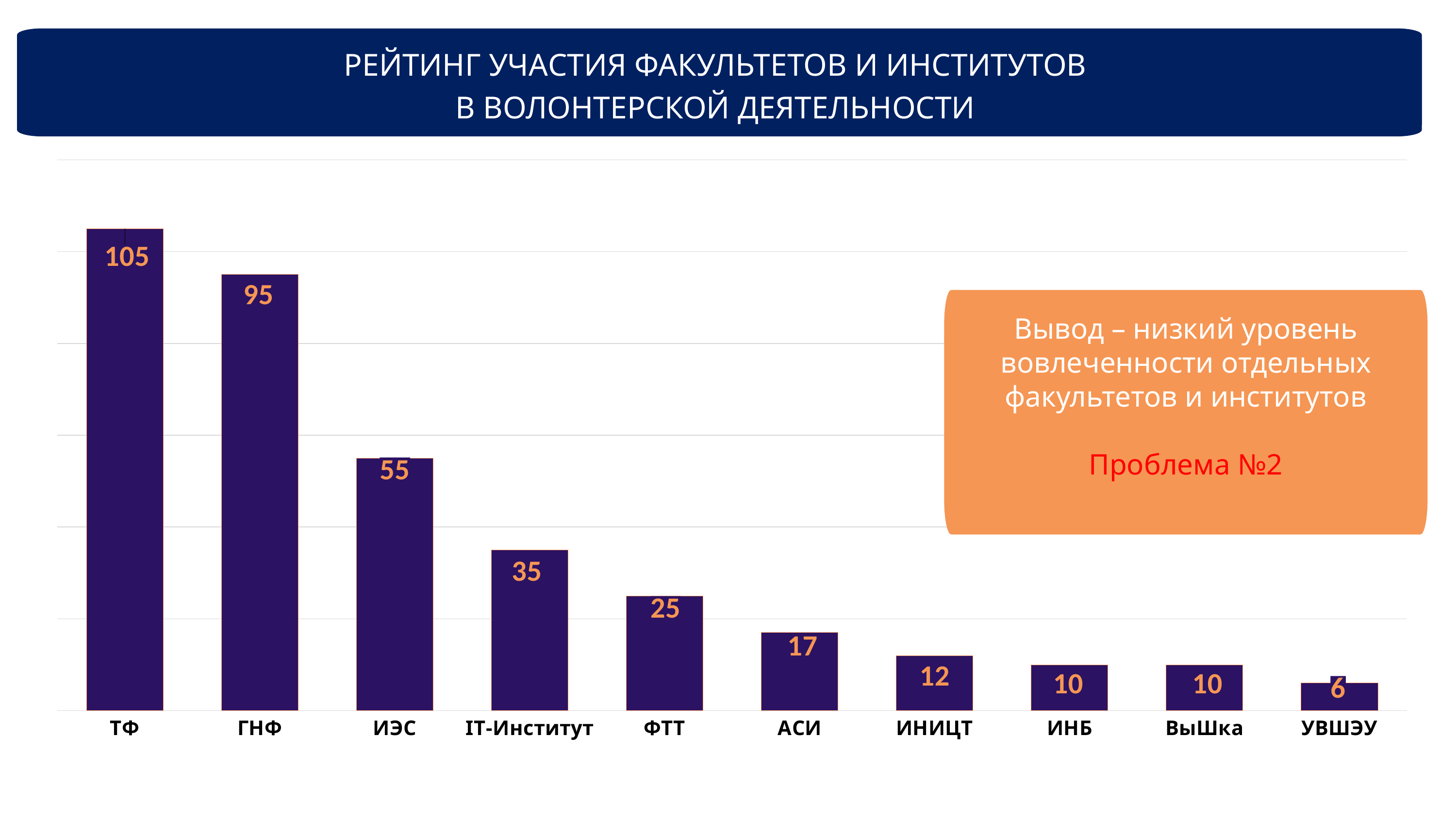
How many categories are shown on the x axis? 10 What is the title of the slide? РЕЙТИНГ УЧАСТИЯ ФАКУЛЬТЕТОВ И ИНСТИТУТОВ В ВОЛОНТЕРСКОЙ ДЕЯТЕЛЬНОСТИ What is the difference between the values for ТФ and ГНФ? 10 Which category has the lowest value? УВШЭУ What is the value for ТФ? 105 What is the value for ИЭС? 55 What kind of chart is shown on the slide? bar chart Do the values rise or fall from left to right along the x axis? fall What is the value for ИНИЦТ? 12 What is the difference between the values for IT-Институт and ФТТ? 10 Which category has the highest value? ТФ Which is larger, the value for АСИ or the value for ИНБ? АСИ